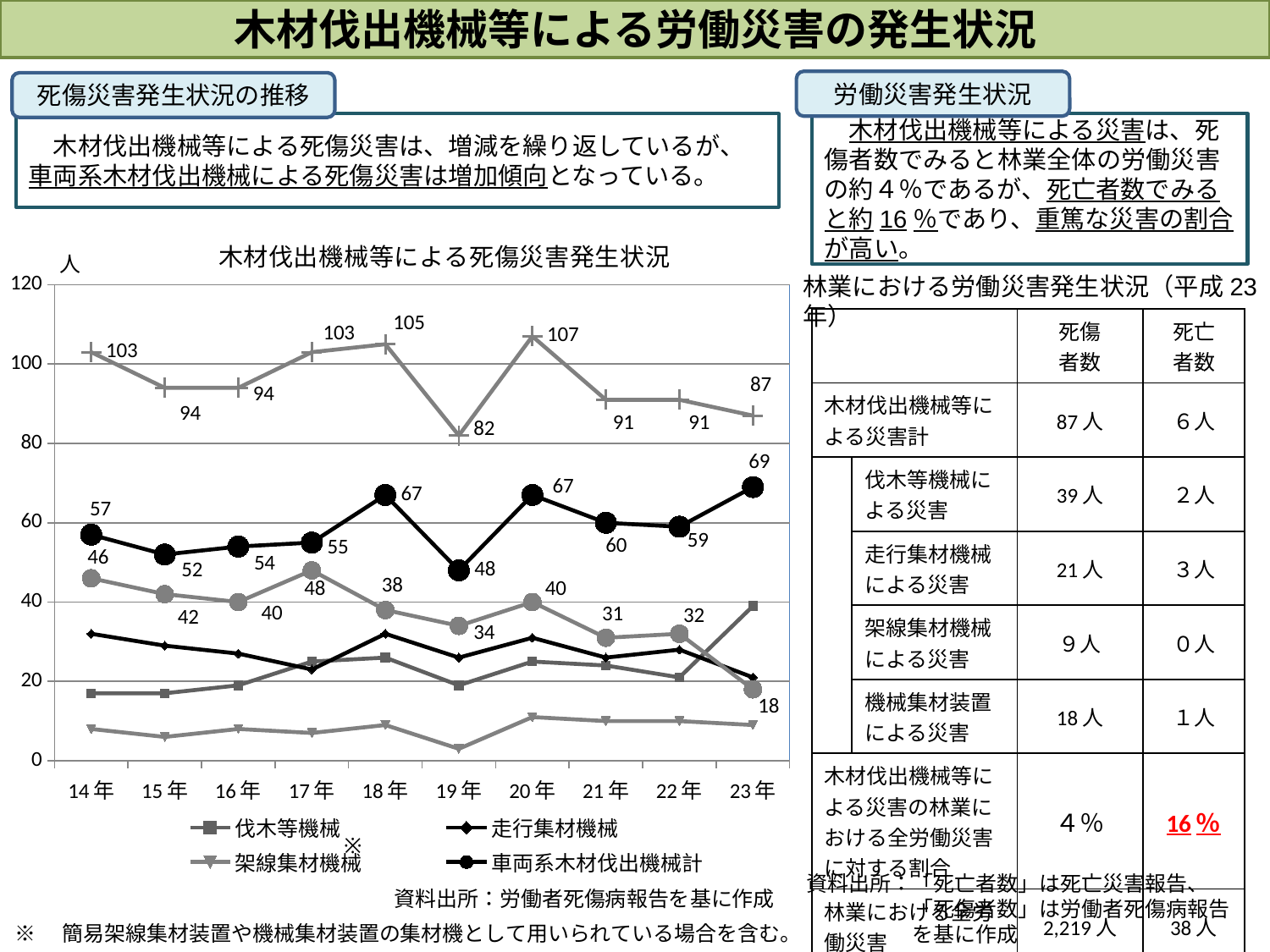
What is the value for 車両系木材伐出機械計 in 14年? 57 In which year is the value for 車両系木材伐出機械計 highest? 23年 Is the value for 架線集材機械 in 19年 greater or less than 10? less How many series does the chart's legend list? 4 Which year has the larger value for 車両系木材伐出機械計, 18年 or 19年? 18年 In which year is the value for 車両系木材伐出機械計 lowest? 19年 What unit is shown at the top of the chart's y axis? 人 What is the value for 車両系木材伐出機械計 in 23年? 69 What is the difference between the 車両系木材伐出機械計 values for 23年 and 22年? 10 How many years are shown along the x axis of the chart? 10 Is the value for 伐木等機械 in 14年 greater or less than 20? less What kind of chart is shown on the slide? line chart